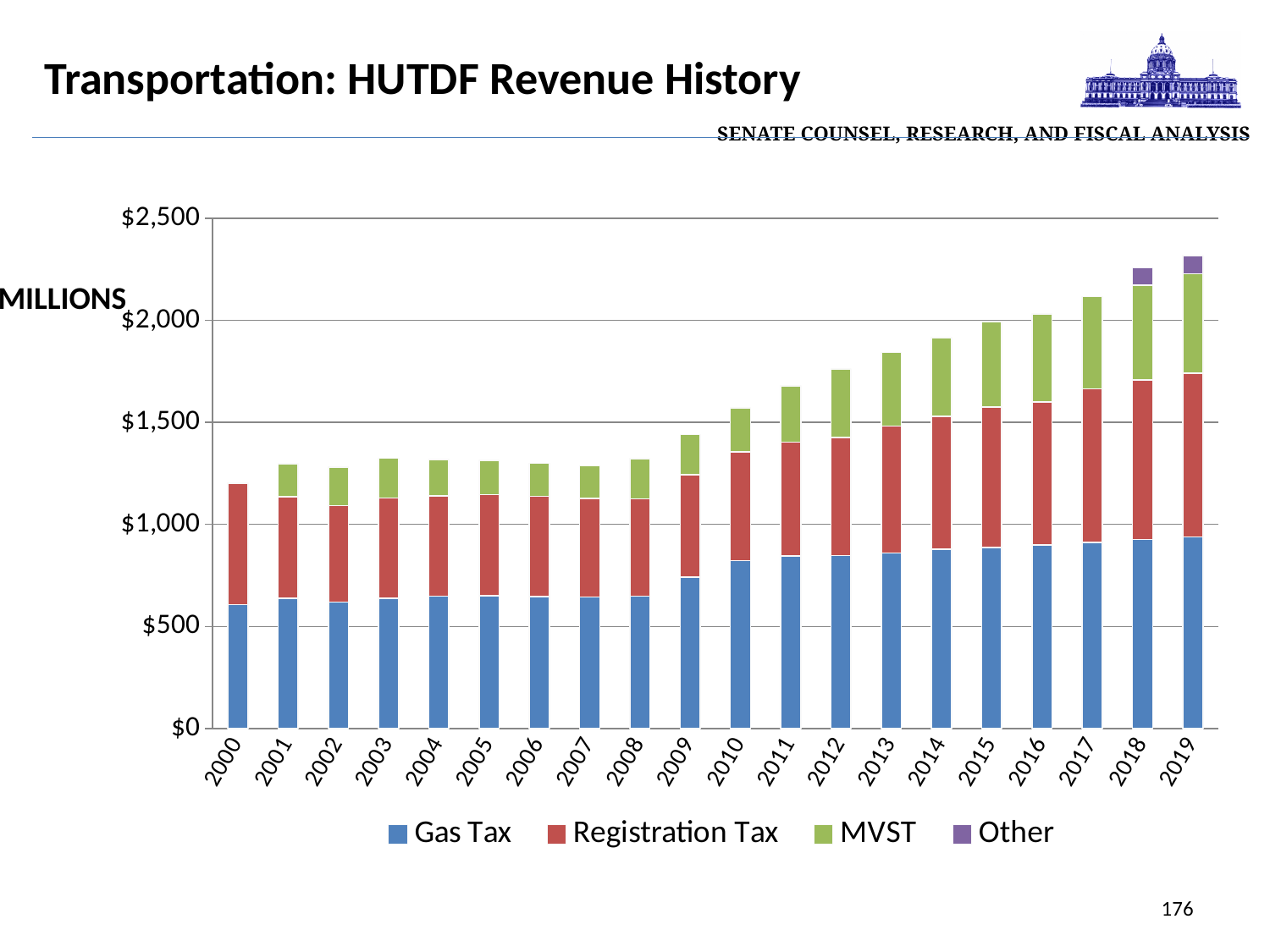
Which is larger, the total revenue for 2019 or for 2000? 2019 Do total revenues generally rise or fall from 2009 to 2019? rise Which year has the highest total HUTDF revenue? 2019 Is the Gas Tax value for 2019 greater or less than $1,000? less How many series does the chart's legend list? 4 What kind of chart is shown on the slide? Stacked bar chart Which legend series appears only in the bars for 2018 and 2019? Other How many years are shown along the x axis of the chart? 20 Which year has the lowest total HUTDF revenue? 2000 Is the total revenue for 2012 greater or less than $1,500? greater Is the total revenue for 2019 greater or less than $2,000? greater